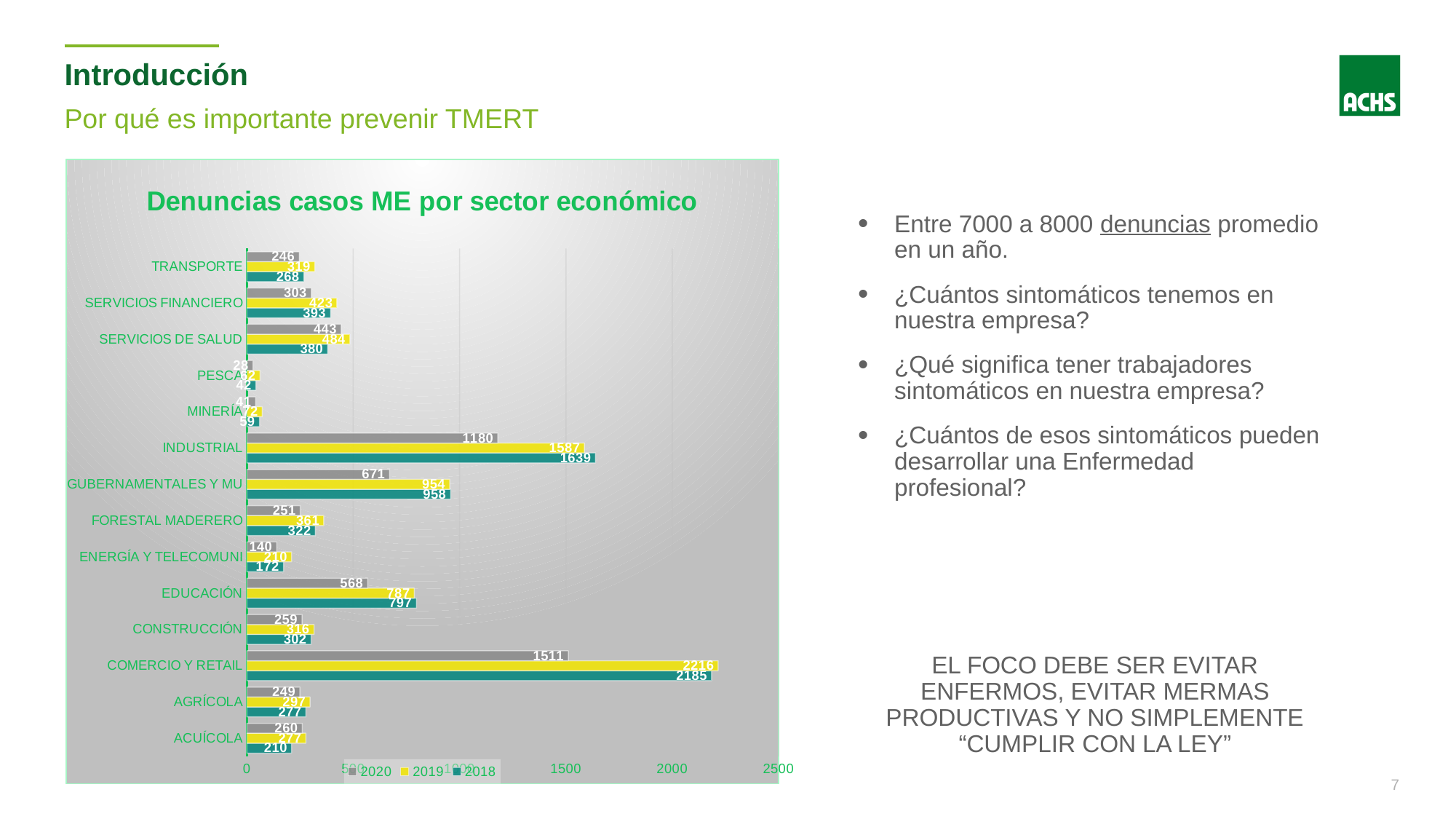
What is the 2020 value for ACUÍCOLA? 260 For SERVICIOS DE SALUD, which is larger: the 2020 value or the 2018 value? 2020 In the chart 'Denuncias casos ME por sector económico', what is the 2018 value for INDUSTRIAL? 1639 How many economic sectors are shown in the chart? 14 What kind of chart is shown on the slide? Bar chart How many series does the legend list? 3 Which sector has the lowest value for 2018? PESCA What is the difference between the 2019 and 2018 values for COMERCIO Y RETAIL? 31 Which sector has the highest value for 2020? COMERCIO Y RETAIL Is the 2020 value for INDUSTRIAL greater or less than 1000? greater What is the 2019 value for COMERCIO Y RETAIL? 2216 What is the difference between the 2019 and 2020 values for EDUCACIÓN? 219